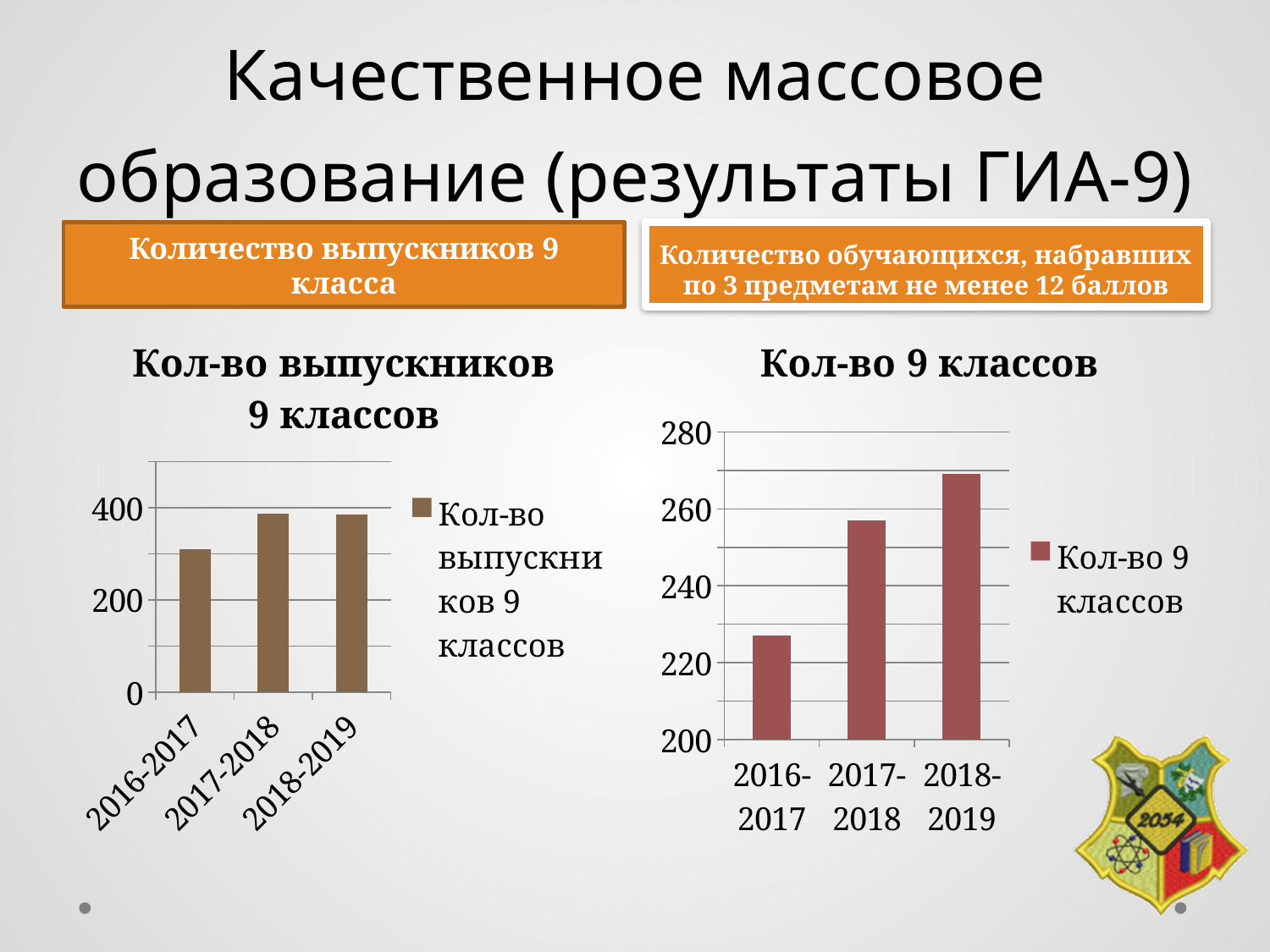
In the left chart "Кол-во выпускников 9 классов", is the value for 2016-2017 greater or less than 400? less What kind of chart is the left chart titled "Кол-во выпускников 9 классов"? bar chart In the left chart "Кол-во выпускников 9 классов", is the value for 2017-2018 greater or less than 200? greater In the left chart "Кол-во выпускников 9 классов", which category has the lowest value? 2016-2017 What kind of chart is the right chart titled "Кол-во 9 классов"? bar chart In the right chart "Кол-во 9 классов", how many series does the legend list? 1 In the right chart "Кол-во 9 классов", do the values rise or fall from 2016-2017 to 2018-2019? rise In the right chart "Кол-во 9 классов", is the value for 2016-2017 greater or less than 240? less In the right chart "Кол-во 9 классов", which category has the highest value? 2018-2019 In the left chart "Кол-во выпускников 9 классов", how many categories are shown on the x axis? 3 In the right chart "Кол-во 9 классов", which category has the lowest value? 2016-2017